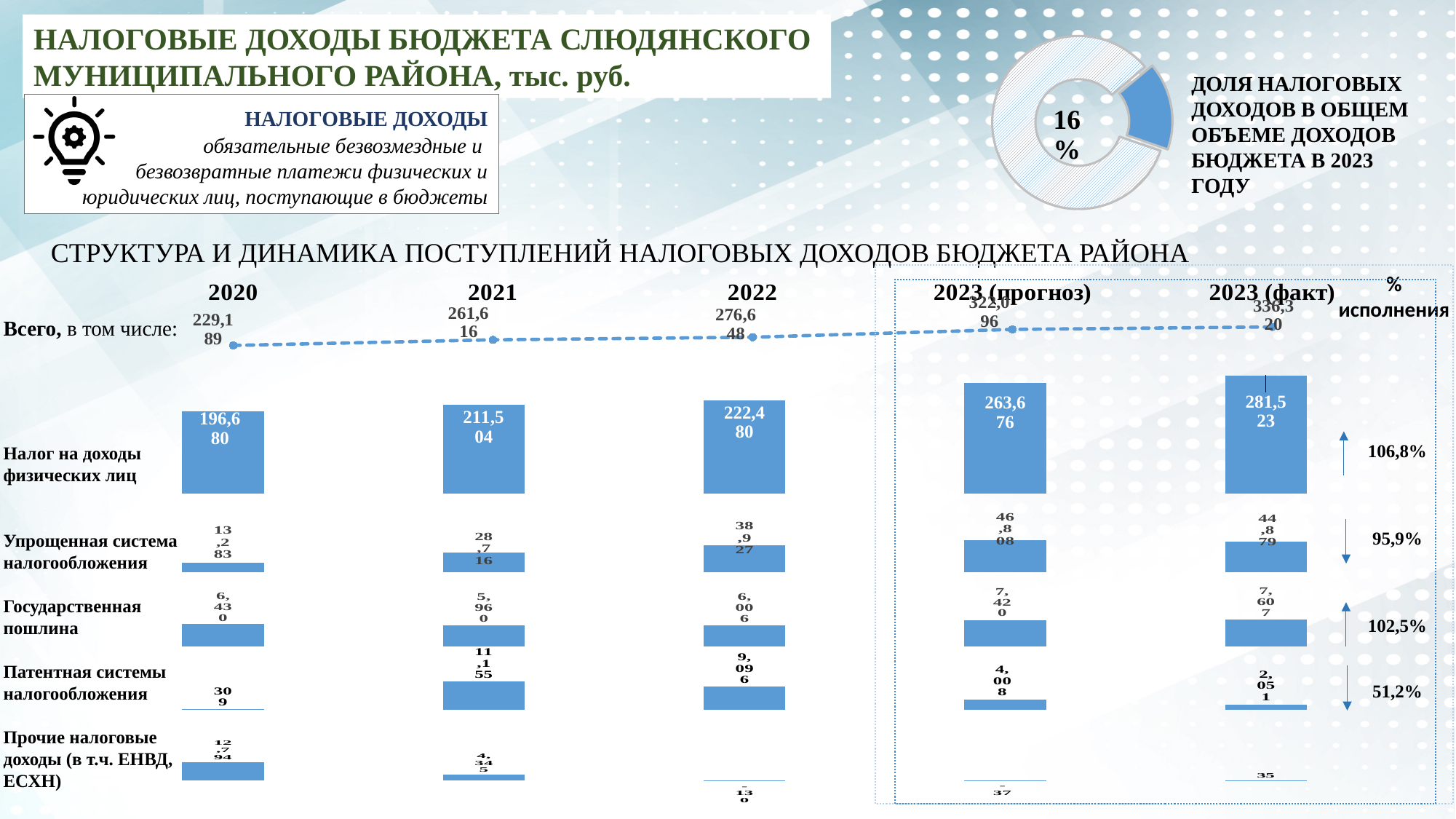
In the chart 'Структура и динамика поступлений налоговых доходов бюджета района', which is larger for 'Упрощенная система налогообложения': 2021 or 2022? 2022 In the chart 'Структура и динамика поступлений налоговых доходов бюджета района', how many year columns are shown? 5 In the chart 'Структура и динамика поступлений налоговых доходов бюджета района', which column has the highest value for 'Налог на доходы физических лиц'? 2023 (факт) In the chart 'Структура и динамика поступлений налоговых доходов бюджета района', what is the value of 'Государственная пошлина' for 2023 (прогноз)? 7,420 In the donut chart at the top right, what share of total budget revenues did tax revenues make up in 2023? 16% In the chart 'Структура и динамика поступлений налоговых доходов бюджета района', what is the value of 'Налог на доходы физических лиц' for 2023 (факт)? 281,523 In the chart 'Структура и динамика поступлений налоговых доходов бюджета района', which column has the lowest value for 'Патентная система налогообложения'? 2020 In the chart 'Структура и динамика поступлений налоговых доходов бюджета района', what is the difference between the 'Всего' values for 2023 (факт) and 2023 (прогноз)? 14,224 In the chart 'Структура и динамика поступлений налоговых доходов бюджета района', does the 'Всего' line rise or fall from 2020 to 2023 (факт)? rises What kind of chart is used for the tax revenue categories in 'Структура и динамика поступлений налоговых доходов бюджета района'? bar chart In the chart 'Структура и динамика поступлений налоговых доходов бюджета района', what is the 'Всего' value for 2020? 229,189 In the chart 'Структура и динамика поступлений налоговых доходов бюджета района', what is the '% исполнения' shown for 'Патентная система налогообложения'? 51,2%